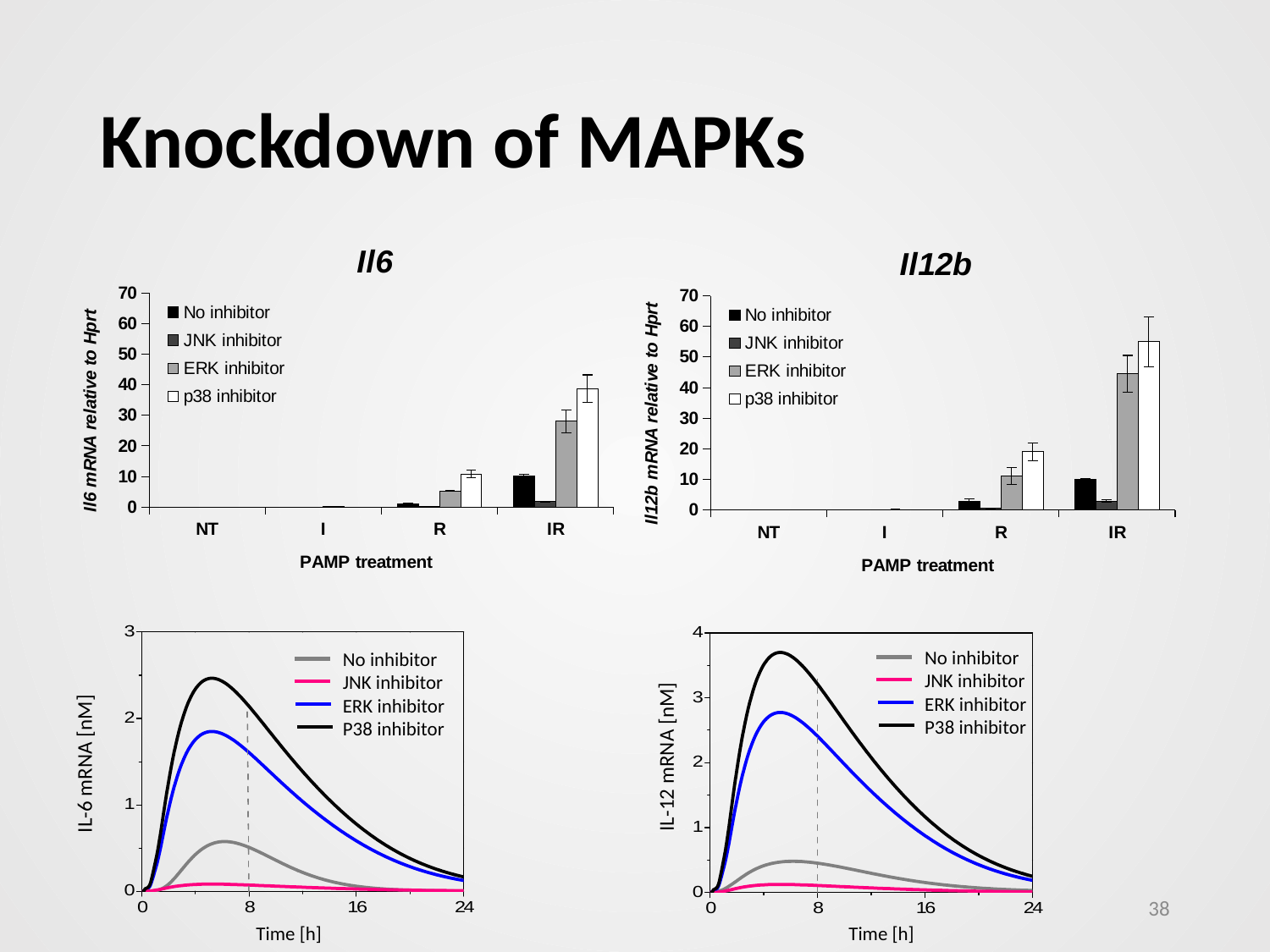
In the IL-12 mRNA line chart, do the curves rise or fall between 8 h and 24 h? fall How many PAMP treatment categories are shown on the x axis of the Il12b bar chart? 4 In the IL-12 mRNA line chart, is the peak value of the P38 inhibitor curve greater or less than 3? greater What kind of chart is the Il6 chart at the top left of the slide? bar chart What kind of chart is the IL-6 mRNA chart at the bottom left of the slide? line chart In the IL-6 mRNA line chart, which series stays lowest across the whole time range? JNK inhibitor In the Il6 bar chart, which inhibitor condition has the highest bar for the IR treatment? p38 inhibitor In the Il6 bar chart, is the p38 inhibitor value for IR greater or less than 30? greater In the Il12b bar chart, which PAMP treatment has the lowest bars overall? NT In the Il12b bar chart, which is larger for the IR treatment: the ERK inhibitor bar or the p38 inhibitor bar? p38 inhibitor In the Il12b bar chart, is the p38 inhibitor value for IR greater or less than 50? greater How many series does the legend of the Il6 bar chart list? 4